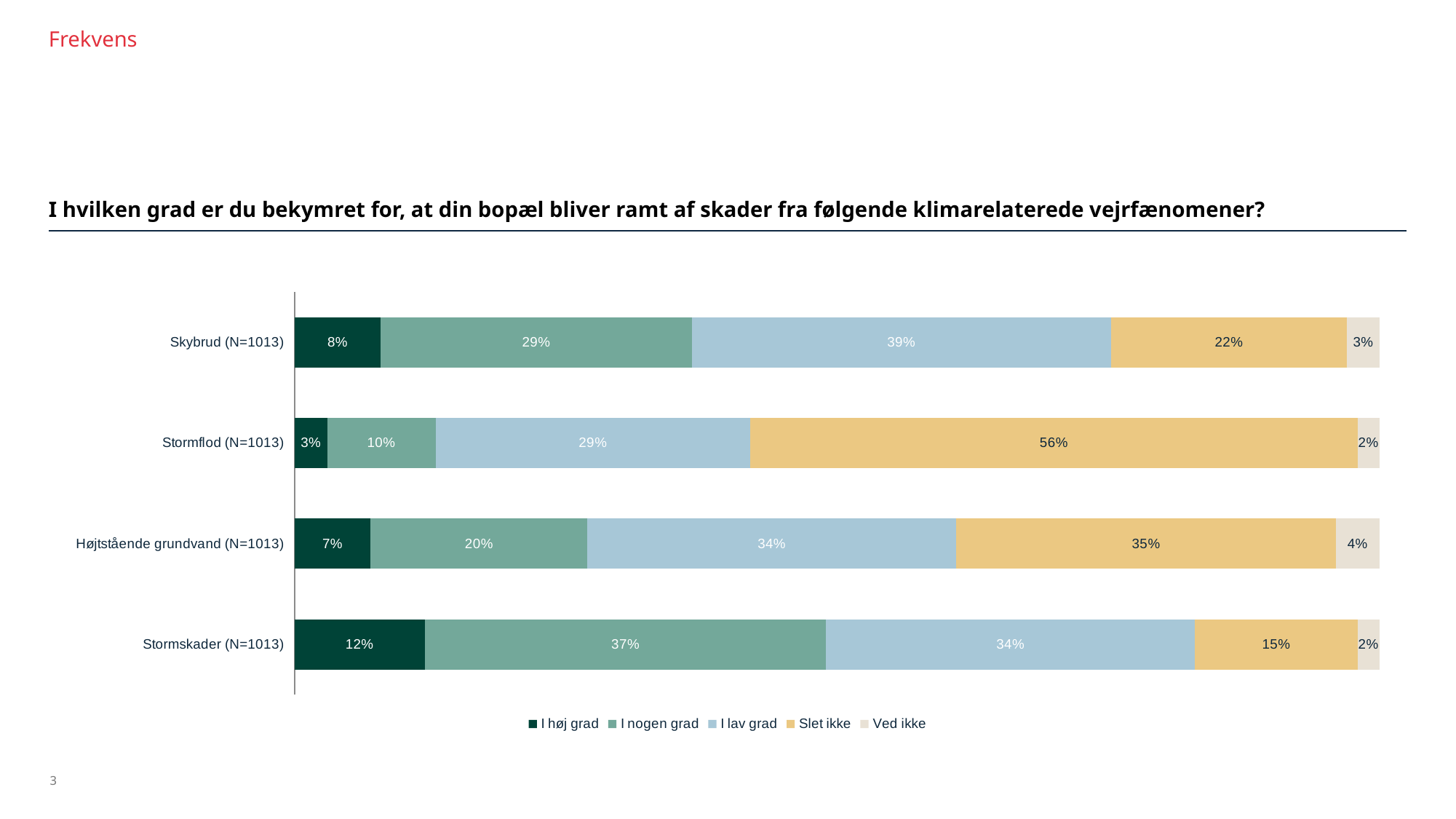
What is the combined share of "I høj grad" and "I nogen grad" for Stormskader (N=1013)? 49% What kind of chart is shown on the slide? Stacked bar chart What percentage of respondents answered "I høj grad" for Stormskader (N=1013)? 12% What percentage of respondents answered "Slet ikke" for Stormflod (N=1013)? 56% How many series does the legend list? 5 What is the difference between the "Slet ikke" share for Stormflod (N=1013) and for Skybrud (N=1013)? 34 percentage points How many categories are shown on the chart? 4 Which category has the highest "I høj grad" share? Stormskader (N=1013) Which is larger: the "I nogen grad" share for Skybrud (N=1013) or for Højtstående grundvand (N=1013)? Skybrud (N=1013) What percentage of respondents answered "Ved ikke" for Højtstående grundvand (N=1013)? 4% Which category has the lowest "I nogen grad" share? Stormflod (N=1013) What percentage of respondents answered "I lav grad" for Skybrud (N=1013)? 39%